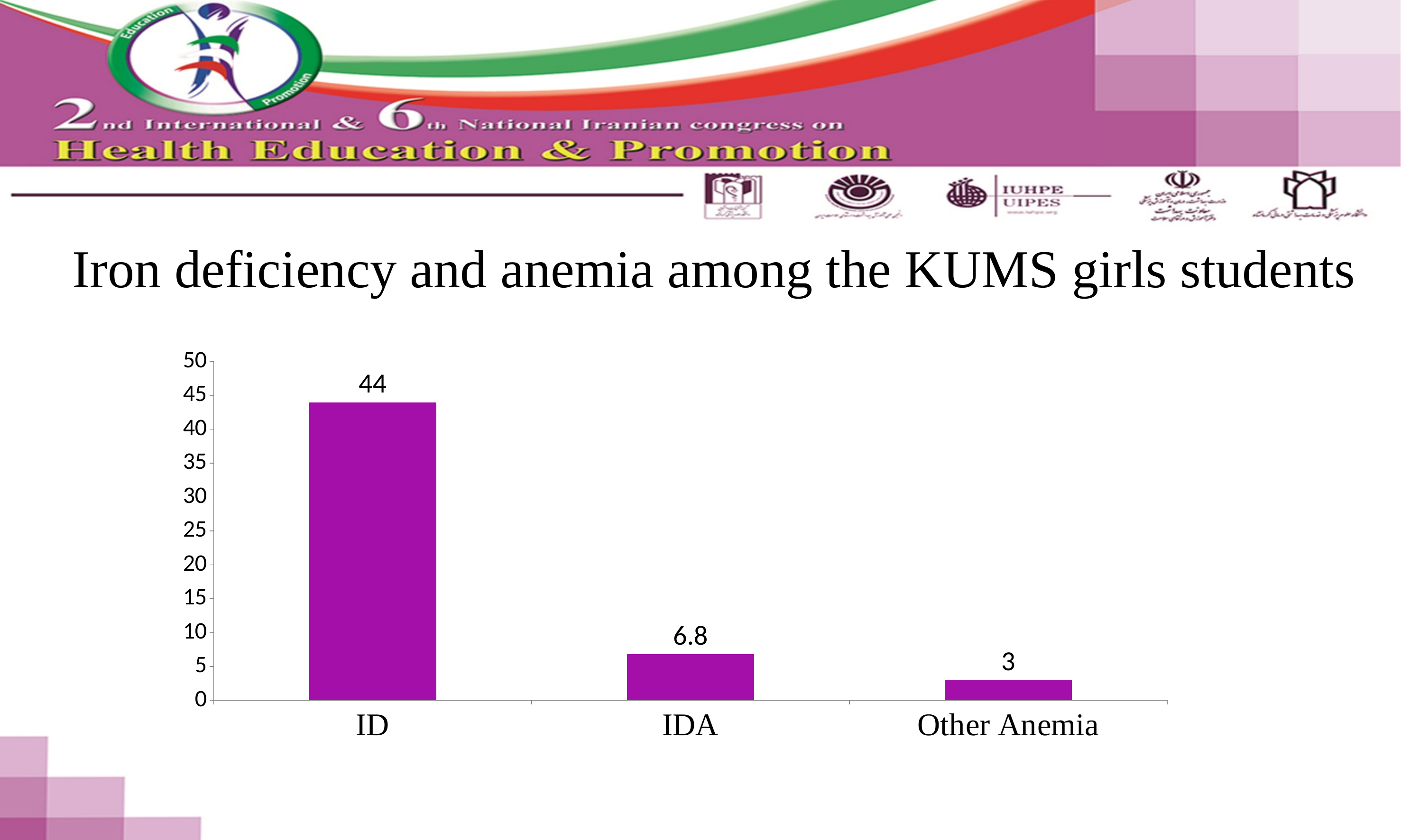
What kind of chart is shown on the slide? bar chart Which is larger, the value for IDA or the value for Other Anemia? IDA Which category has the lowest value? Other Anemia What is the value for Other Anemia? 3 How many categories are shown on the x axis? 3 What is the value for IDA? 6.8 Is the value for ID greater or less than 40? greater What is the difference between the values for IDA and Other Anemia? 3.8 What is the difference between the values for ID and IDA? 37.2 Which category has the highest value? ID Do the values rise or fall from left to right along the x axis? fall What is the value for ID? 44